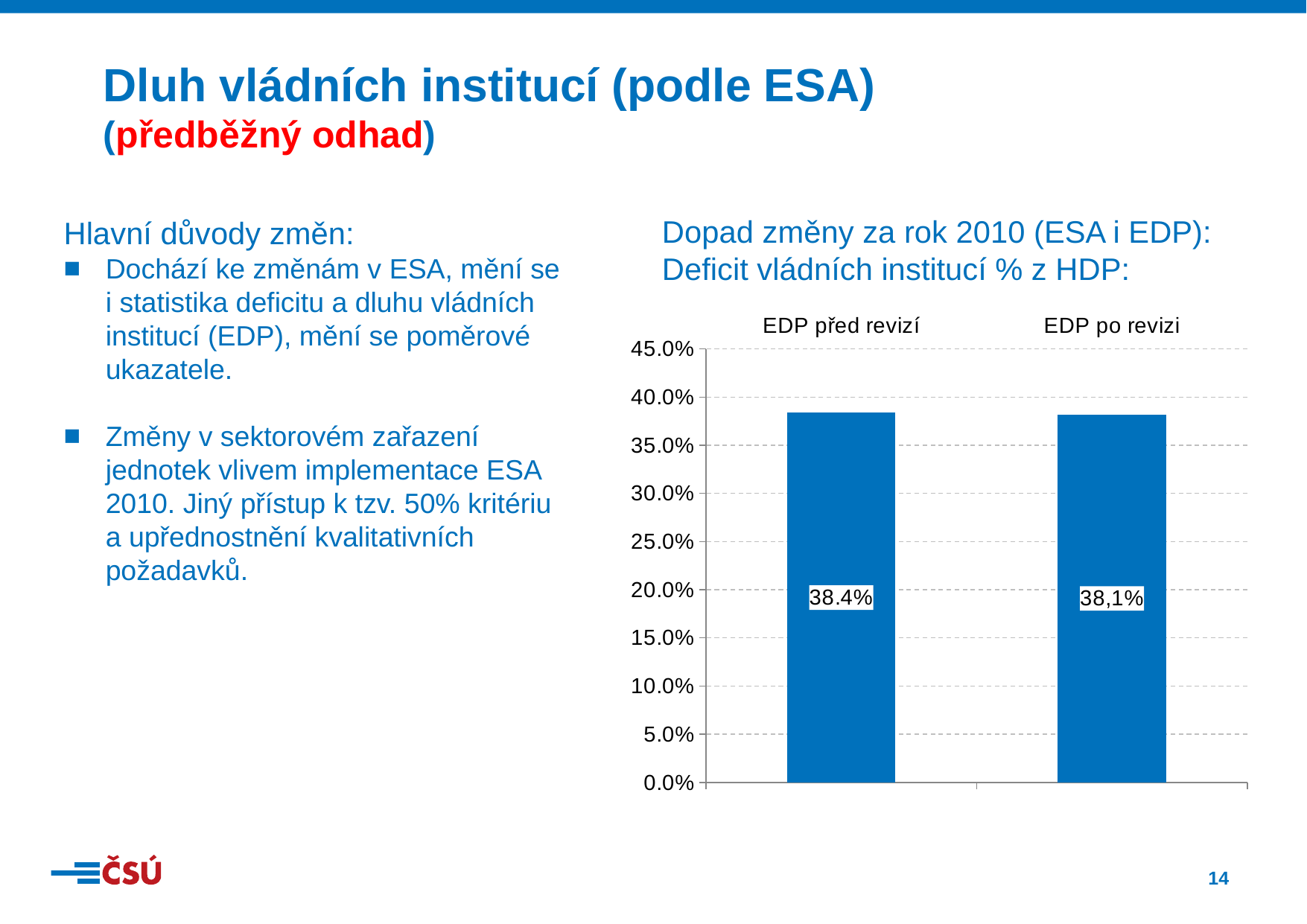
What is the value shown for EDP po revizi? 38,1% What is the difference between the EDP před revizí value and the EDP po revizi value? 0.3% Which category has the lowest value in the chart? EDP po revizi Which bar has the higher value, EDP před revizí or EDP po revizi? EDP před revizí Is the value for EDP před revizí greater or less than 35.0%? greater What is the value shown for EDP před revizí? 38.4% How many bars are plotted in the chart? 2 What is the highest value shown on the vertical axis of the chart? 45.0% What colour are the bars in the chart? blue Is the value for EDP po revizi greater or less than 40.0%? less What kind of chart is shown on the slide? bar chart